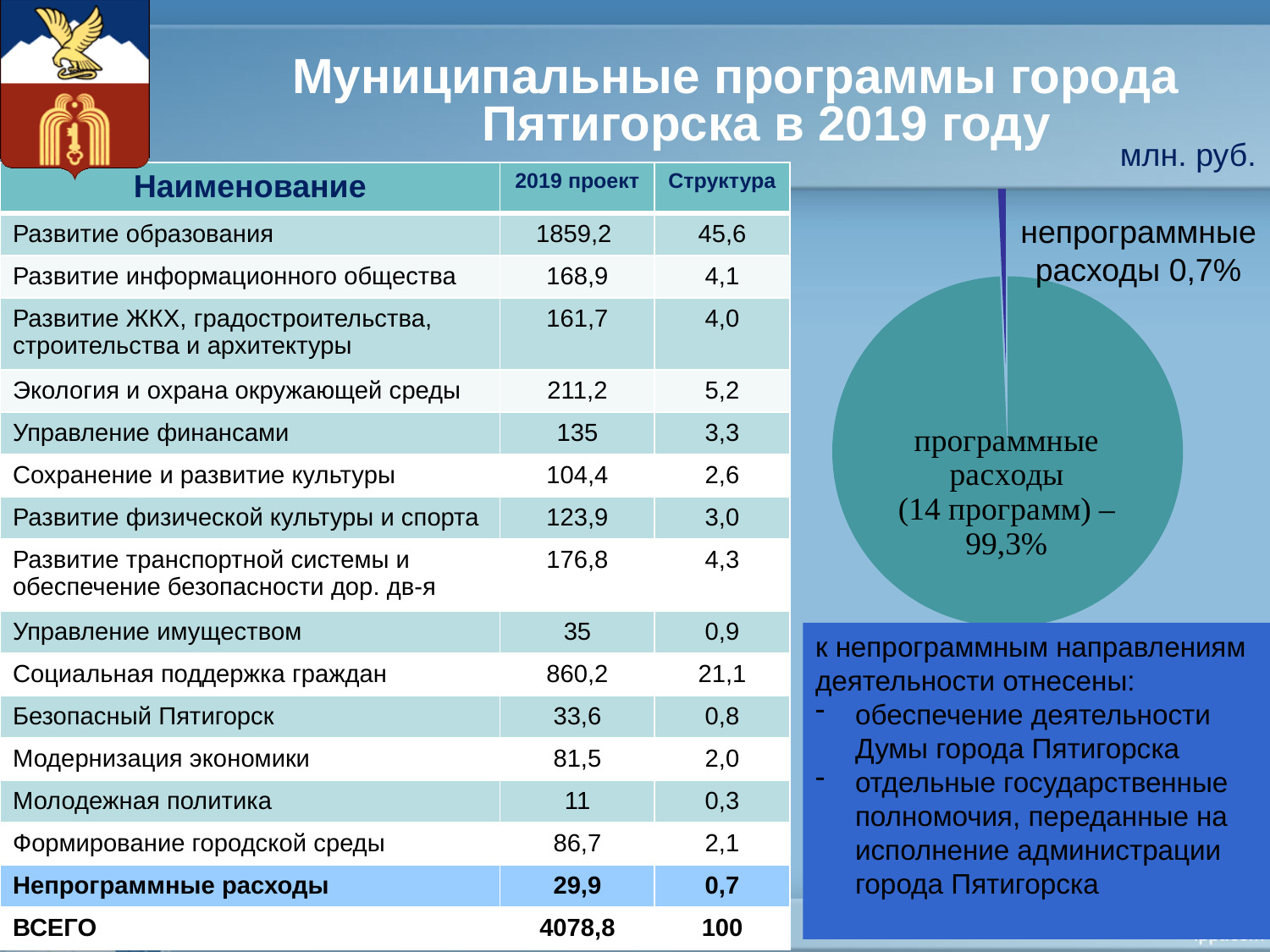
How many slices does the pie chart have? 2 Which slice of the pie chart is the smallest? непрограммные расходы What share of the pie chart is taken by программные расходы? 99,3% What kind of chart is shown on the right side of the slide? pie chart Which slice of the pie chart is the largest? программные расходы Is the share of непрограммные расходы in the pie chart greater or less than 1%? less In the pie chart, which is larger: программные расходы or непрограммные расходы? программные расходы What is the difference in percentage points between the программные расходы slice and the непрограммные расходы slice in the pie chart? 98,6 What share of the pie chart is taken by непрограммные расходы? 0,7% How many programs are included in the программные расходы slice of the pie chart? 14 What unit of measurement is indicated above the pie chart? млн. руб.